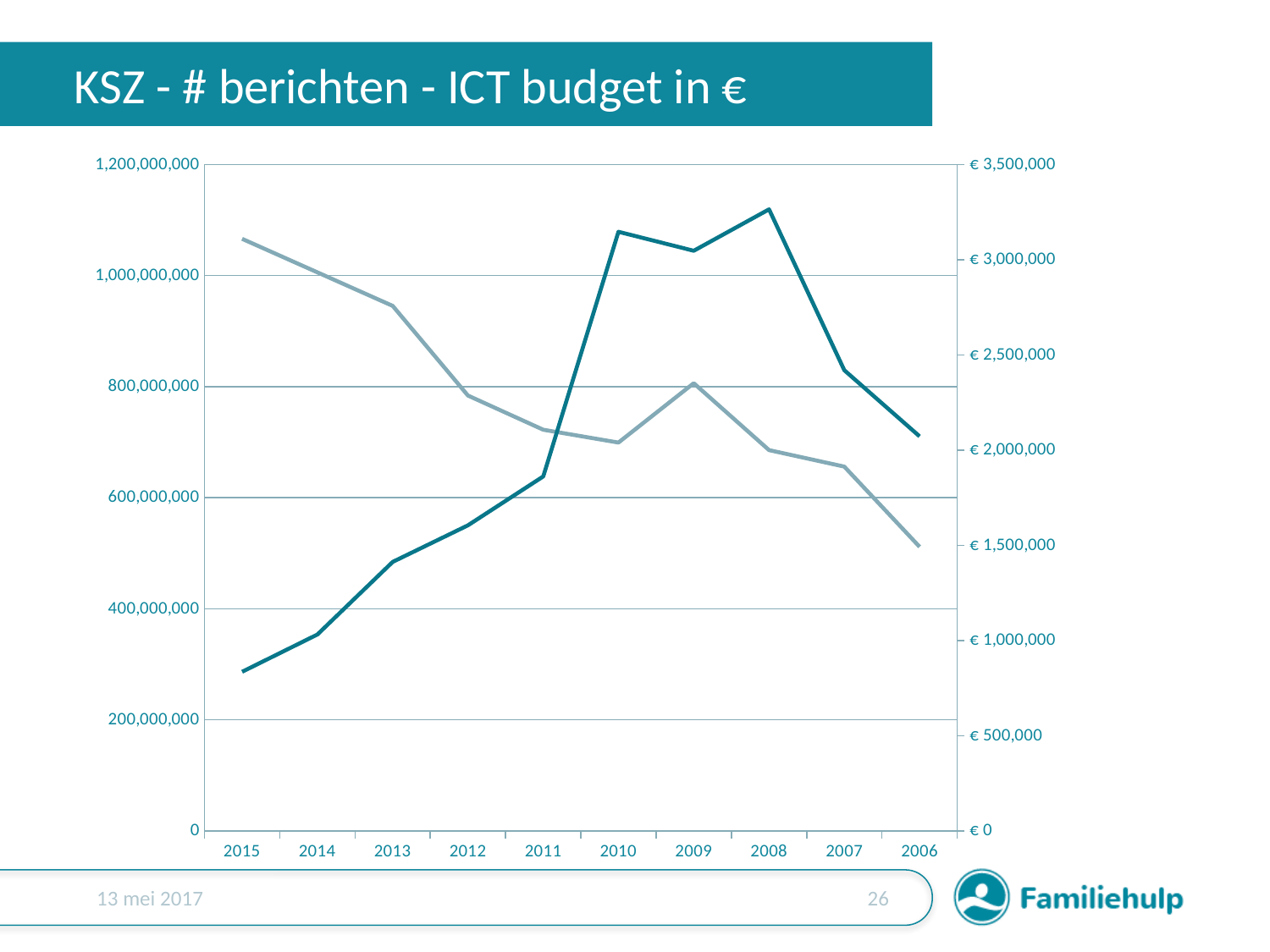
What is the title of the chart? KSZ - # berichten - ICT budget in € On the left-hand axis, is the value of the darker line for 2015 greater or less than 400,000,000? less At 2008, which line is higher on the chart, the darker line or the lighter line? the darker line In which year is the lighter line at its highest point? 2015 In which year is the darker line at its lowest point? 2015 In which year is the lighter line at its lowest point? 2006 On the left-hand axis, is the value of the lighter line for 2015 greater or less than 1,000,000,000? greater How many lines are plotted on the chart? 2 How many years are shown on the x axis of the chart? 10 In which year does the darker line reach its highest point? 2008 What kind of chart is shown on the slide? line chart What is the highest value shown on the right-hand axis of the chart? € 3,500,000